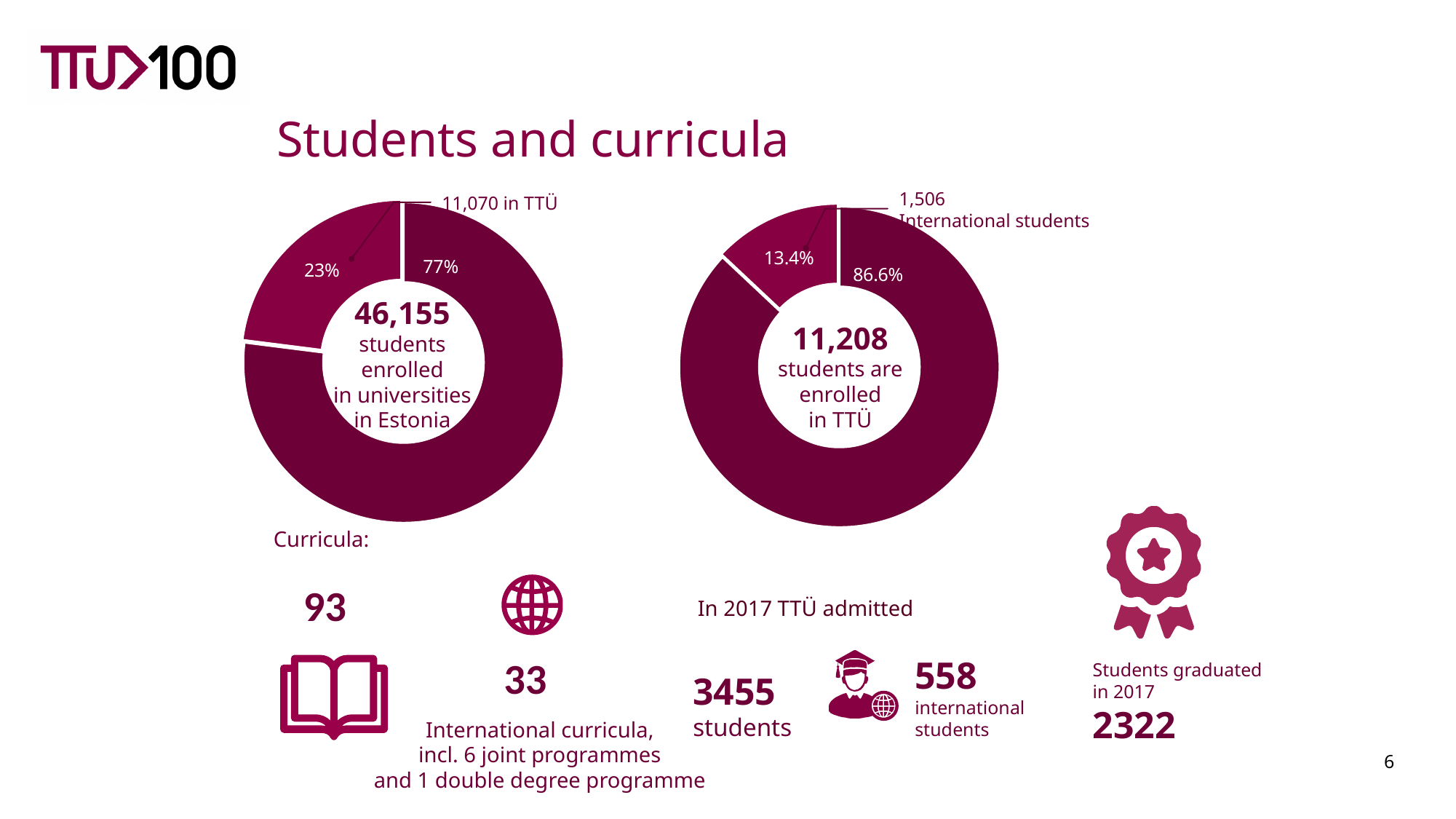
In the left chart, what percentage is shown for the larger slice? 77% In the left chart, what share of students enrolled in universities in Estonia are in TTÜ? 23% In the left chart, which slice is larger: the 23% TTÜ slice or the 77% slice? The 77% slice In the left chart, what is the total number of students enrolled in universities in Estonia shown in the centre? 46,155 What kind of chart is the left chart showing students enrolled in universities in Estonia? Donut (pie) chart How many slices does the right chart have? 2 What is the difference in percentage points between the two slices of the right chart? 73.2 percentage points In the right chart, what is the total number of students enrolled in TTÜ shown in the centre? 11,208 In the right chart, what share of TTÜ students are international students? 13.4% In the right chart, how many international students are there according to the slice label? 1,506 In the right chart, what percentage is shown for the larger slice? 86.6% In the left chart, how many students are in TTÜ according to the slice label? 11,070